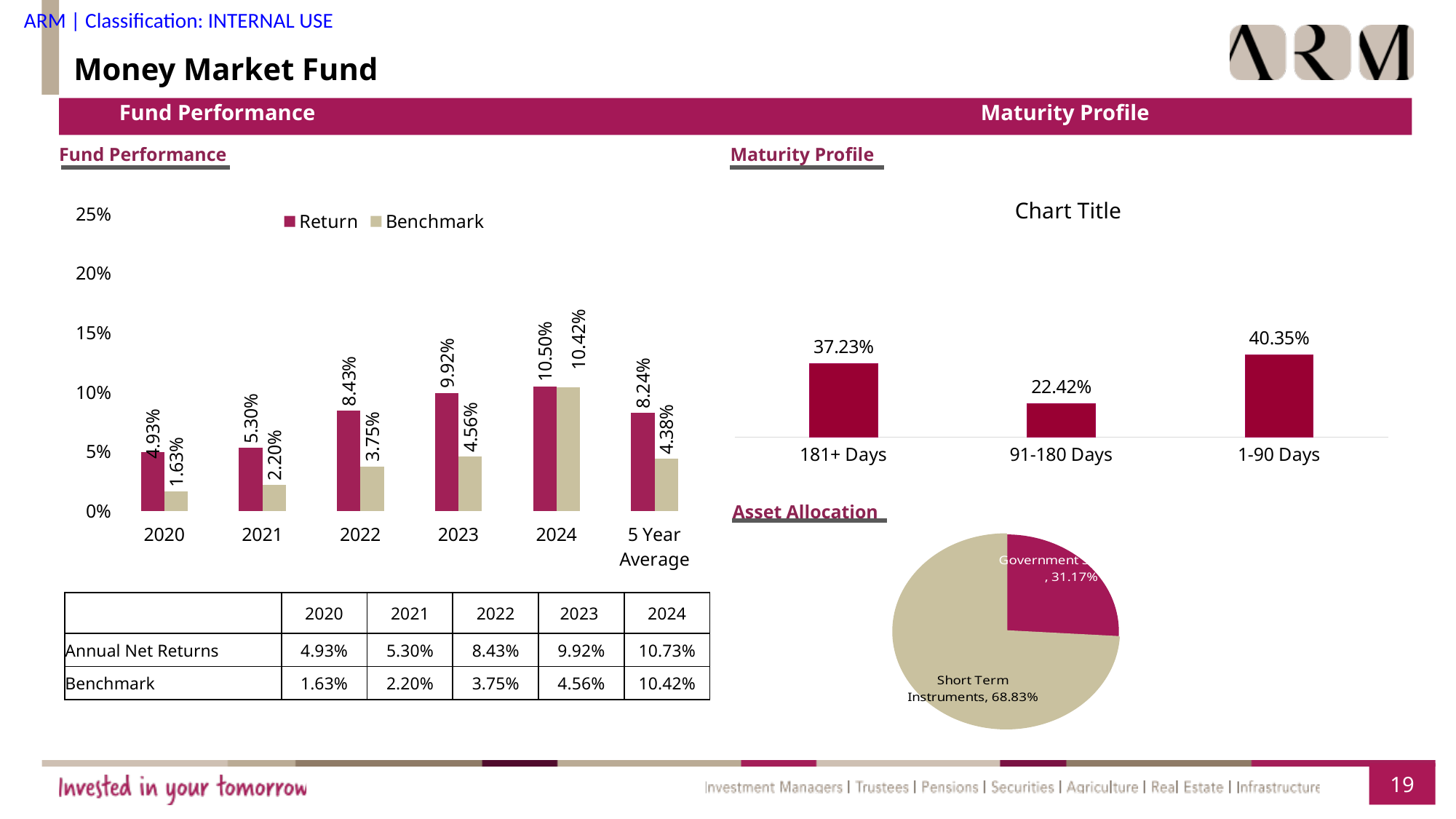
How many series does the legend of the Fund Performance chart list? 2 In the Fund Performance chart, which year has the highest Return? 2024 In the Maturity Profile chart, which category has the highest value? 1-90 Days In the Fund Performance chart, which is larger: the Return for 2022 or the Return for 2023? 2023 In the Asset Allocation pie chart, what share is Short Term Instruments? 68.83% In the Fund Performance chart, what is the Benchmark value for 2023? 4.56% In the Fund Performance chart, which category has the lowest Benchmark value? 2020 How many categories are shown on the x axis of the Fund Performance chart? 6 In the Maturity Profile chart, what is the value for 91-180 Days? 22.42% In the Fund Performance chart, does the Return rise or fall from 2020 to 2024? rise In the Fund Performance chart, what is the difference between the Return and the Benchmark for 2021? 3.10% In the Fund Performance chart, what is the Return value for 2022? 8.43%